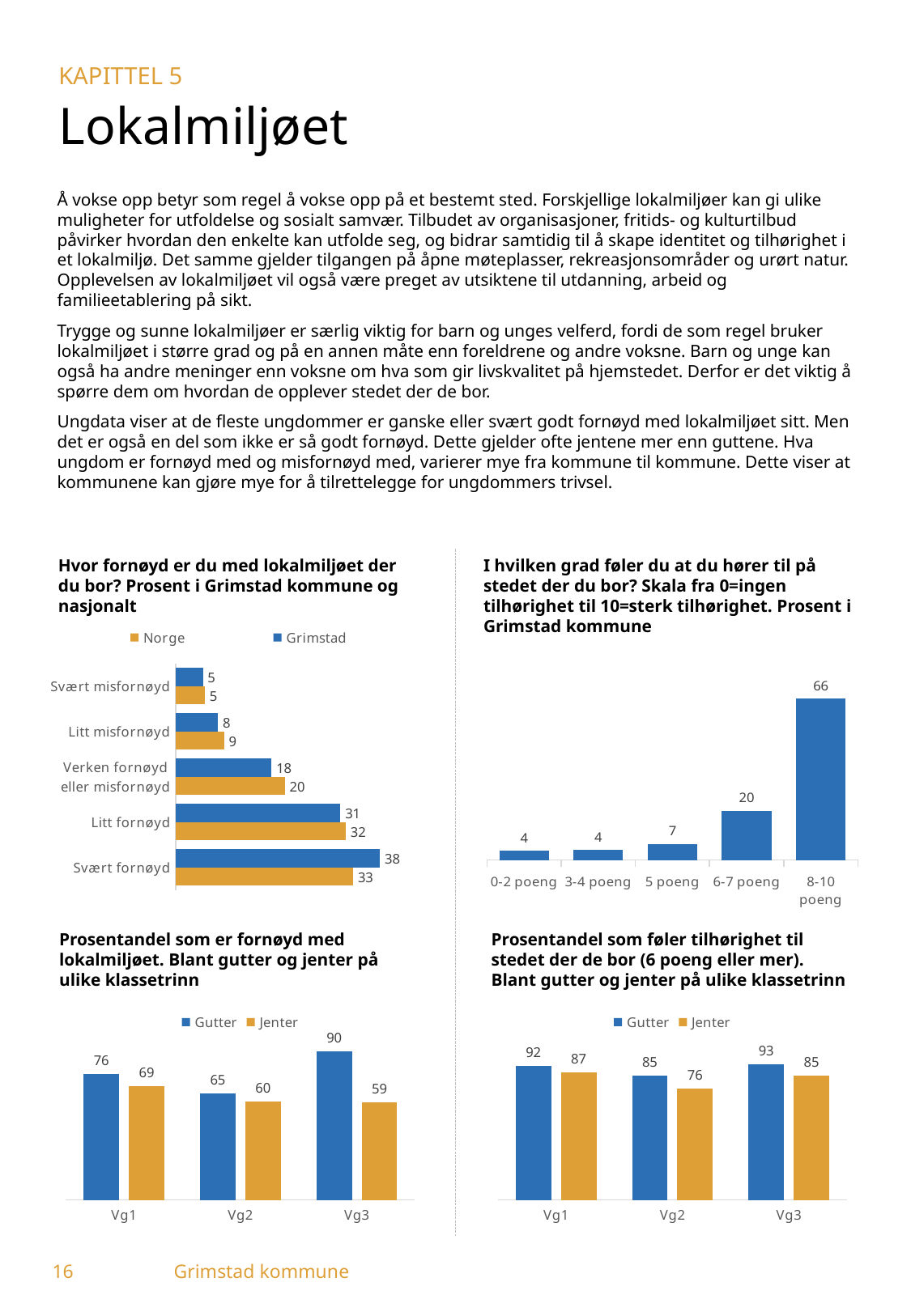
In the bottom-right chart 'Prosentandel som føler tilhørighet til stedet der de bor', what is the difference between the Gutter and Jenter values for Vg1? 5 In the bottom-right chart 'Prosentandel som føler tilhørighet til stedet der de bor', what is the Jenter value for Vg2? 76 In the top-right chart 'I hvilken grad føler du at du hører til på stedet der du bor?', what is the value for '6-7 poeng'? 20 In the top-left chart 'Hvor fornøyd er du med lokalmiljøet der du bor?', what is the Norge value for 'Verken fornøyd eller misfornøyd'? 20 How many categories are shown in the top-right chart 'I hvilken grad føler du at du hører til på stedet der du bor?'? 5 In the top-left chart 'Hvor fornøyd er du med lokalmiljøet der du bor?', what is the Grimstad value for 'Svært fornøyd'? 38 How many series does the legend of the top-left chart 'Hvor fornøyd er du med lokalmiljøet der du bor?' list? 2 In the bottom-left chart 'Prosentandel som er fornøyd med lokalmiljøet', which is larger for Vg2: Gutter or Jenter? Gutter What kind of chart is the top-right chart 'I hvilken grad føler du at du hører til på stedet der du bor?'? Bar chart In the bottom-left chart 'Prosentandel som er fornøyd med lokalmiljøet', what is the Gutter value for Vg3? 90 In the top-right chart 'I hvilken grad føler du at du hører til på stedet der du bor?', which category has the highest value? 8-10 poeng In the top-left chart 'Hvor fornøyd er du med lokalmiljøet der du bor?', what is the difference between the Grimstad and Norge values for 'Svært fornøyd'? 5